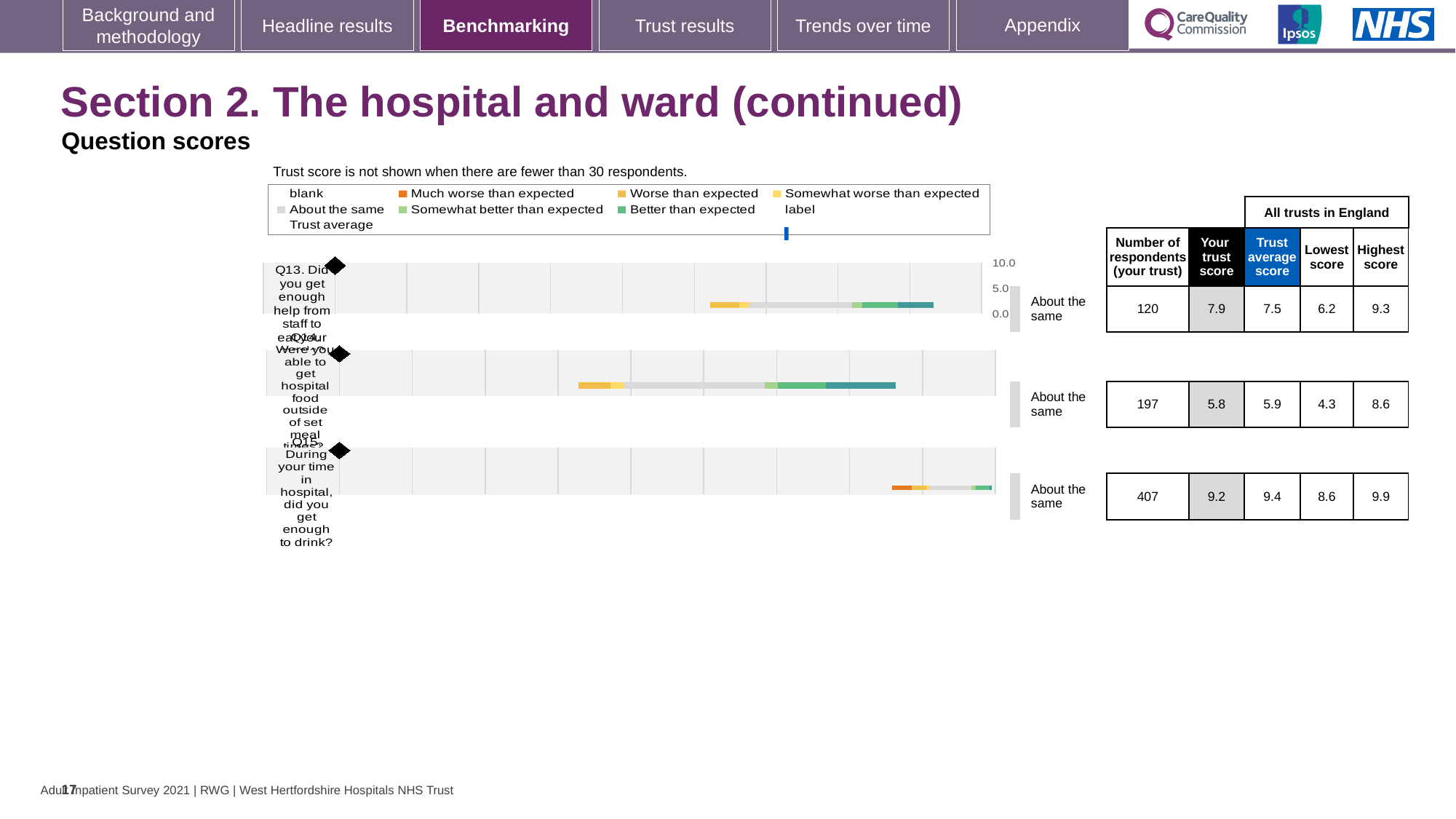
Which question has the lowest 'Your trust score' on this slide? Q14 What benchmark category is shown for Q14 on this slide? About the same What is the highest score across all trusts in England for Q15? 9.9 What is the 'Your trust score' for Q13 (Did you get enough help from staff to eat your meals?)? 7.9 For Q13, which is larger: the trust's own score or the trust average score? Your trust score (7.9) What is the difference between the highest score (9.3) and the lowest score (6.2) across all trusts in England for Q13? 3.1 Is the trust score for Q14 greater or less than 5.0? greater How many respondents answered Q15 (did you get enough to drink?) for this trust? 407 What is the trust average score for Q14 (Were you able to get hospital food outside of set meal times?)? 5.9 Which question has the highest 'Your trust score' on this slide? Q15 How many questions (bars) are shown in the benchmarking chart on this slide? 3 What kind of chart is used to show the question scores on this slide? Bar chart